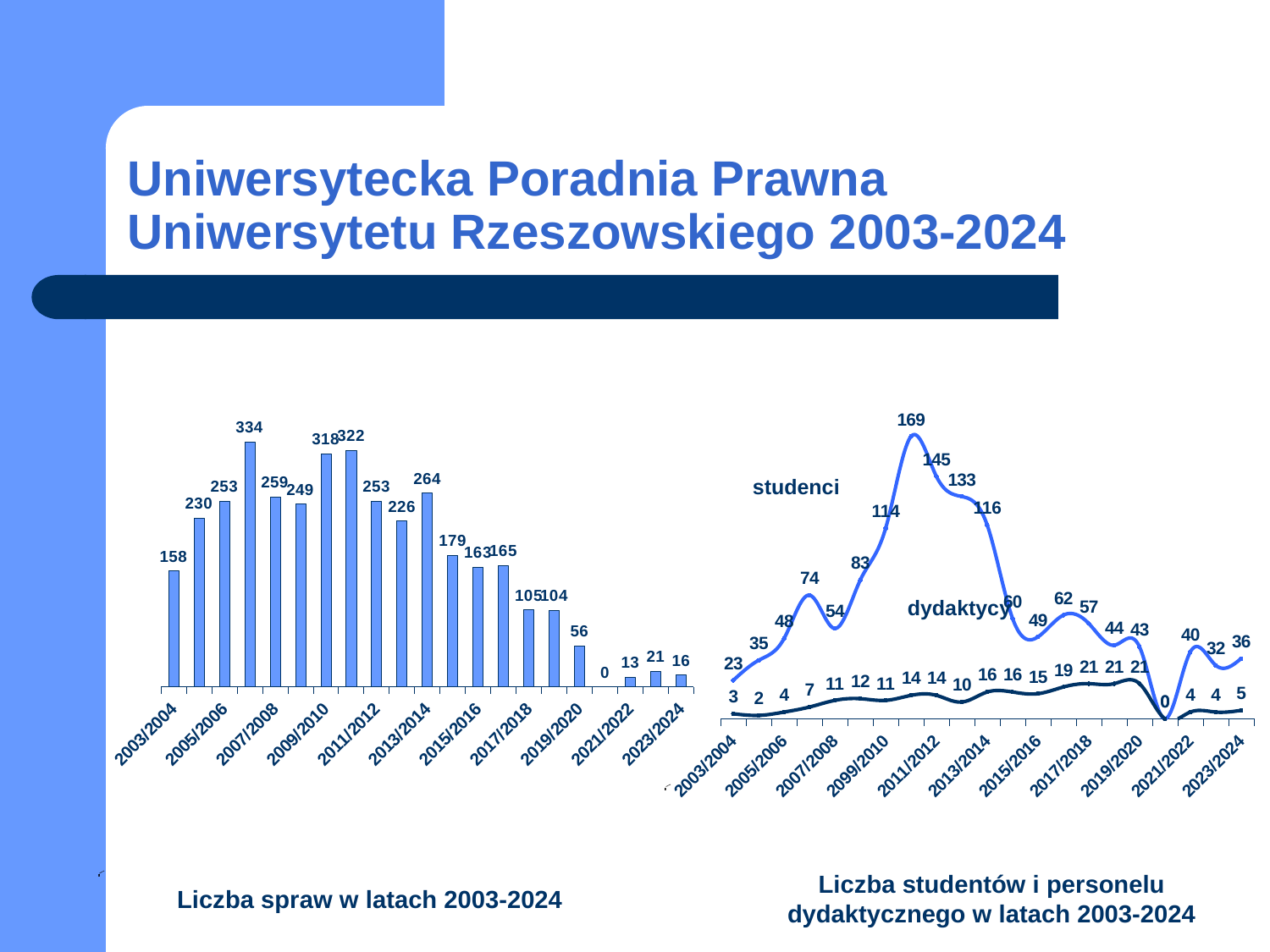
In the right chart 'Liczba studentów i personelu dydaktycznego w latach 2003-2024', what is the highest value of the studenci series? 169 In the left chart 'Liczba spraw w latach 2003-2024', what is the highest value shown? 334 In the left chart 'Liczba spraw w latach 2003-2024', what is the lowest value shown? 0 In the left chart 'Liczba spraw w latach 2003-2024', what is the difference between the values for 2005/2006 and 2003/2004? 95 In the left chart 'Liczba spraw w latach 2003-2024', what is the value for 2023/2024? 16 In the right chart 'Liczba studentów i personelu dydaktycznego w latach 2003-2024', what is the dydaktycy value for 2003/2004? 3 What kind of chart is the left chart 'Liczba spraw w latach 2003-2024'? bar chart In the right chart 'Liczba studentów i personelu dydaktycznego w latach 2003-2024', which series has the larger value for 2023/2024, studenci or dydaktycy? studenci In the left chart 'Liczba spraw w latach 2003-2024', what is the value for 2003/2004? 158 How many series are plotted in the right chart 'Liczba studentów i personelu dydaktycznego w latach 2003-2024'? 2 What kind of chart is the right chart 'Liczba studentów i personelu dydaktycznego w latach 2003-2024'? line chart How many bars are plotted in the left chart 'Liczba spraw w latach 2003-2024'? 21